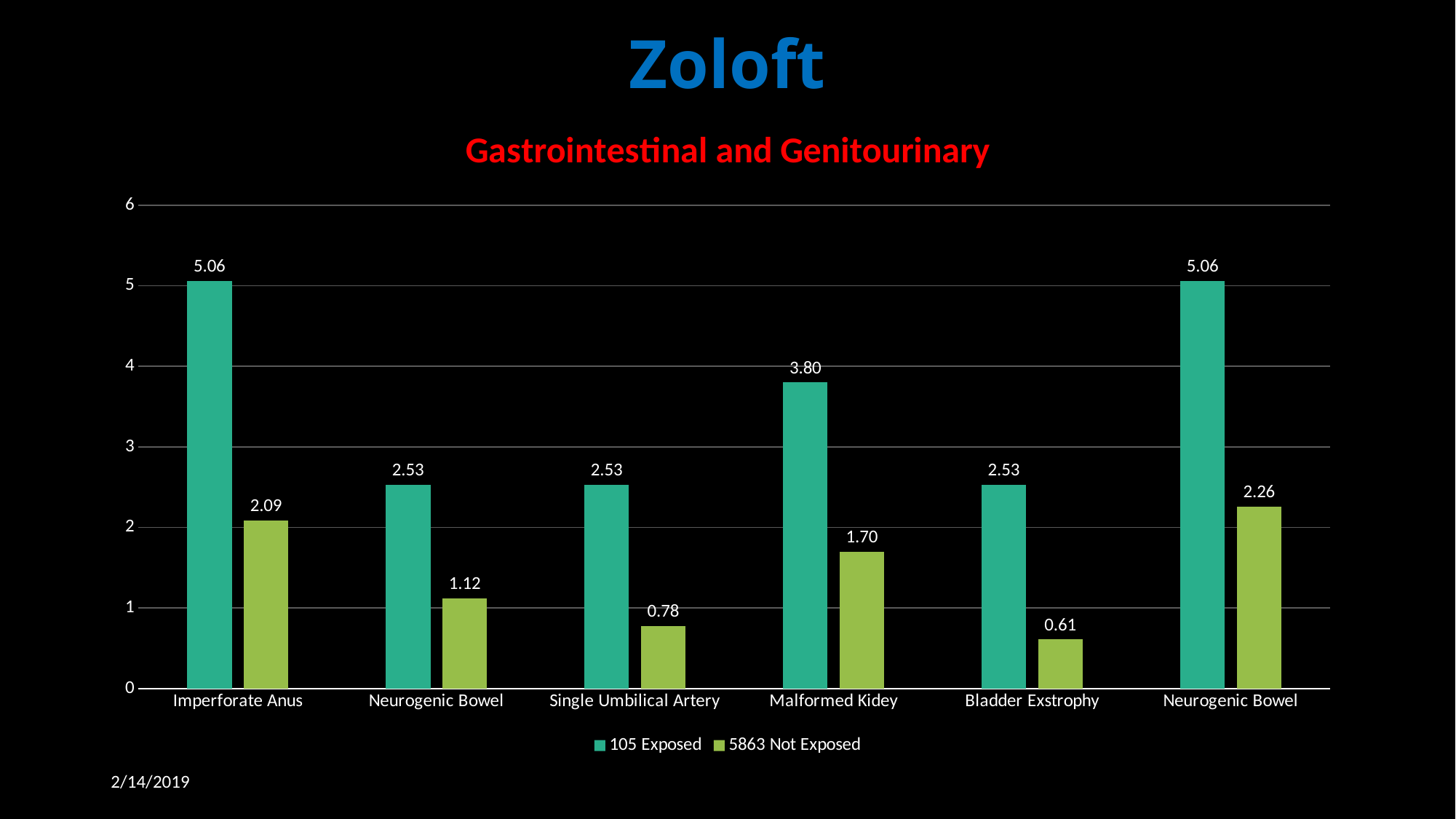
What is the difference between the 105 Exposed and 5863 Not Exposed values for Malformed Kidey? 2.10 Which is larger for 5863 Not Exposed: Imperforate Anus or Malformed Kidey? Imperforate Anus What kind of chart is shown on the slide? bar chart Which category has the lowest value for 5863 Not Exposed? Bladder Exstrophy What is the value for 105 Exposed for Bladder Exstrophy? 2.53 Is the 105 Exposed value for Malformed Kidey greater or less than 3? greater What is the value for 5863 Not Exposed for Malformed Kidey? 1.70 How many series does the legend list? 2 What is the value for 105 Exposed for Imperforate Anus? 5.06 How many categories are shown on the x axis? 6 What is the value for 5863 Not Exposed for Single Umbilical Artery? 0.78 What is the difference between the 105 Exposed and 5863 Not Exposed values for Imperforate Anus? 2.97